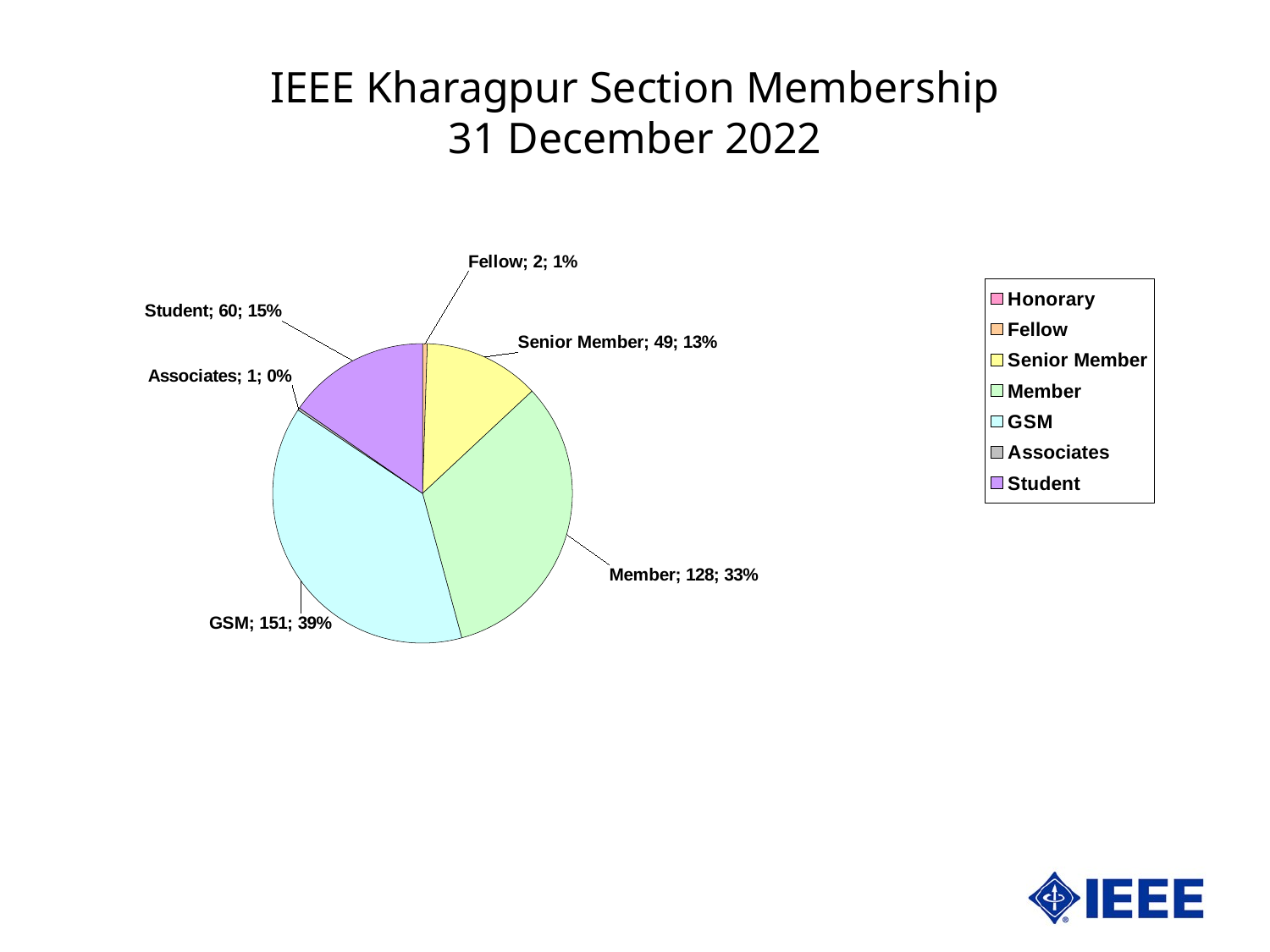
What is the difference between the GSM count and the Member count? 23 How many Senior Members are shown in the chart? 49 What is the value shown for Student? 60 What is the title of the chart? IEEE Kharagpur Section Membership 31 December 2022 How many entries does the legend list? 7 Which labelled category has the smallest value in the chart? Associates What kind of chart is shown on the slide? pie chart What percentage of the membership is Member? 33% Which is larger, the Student count or the Senior Member count? Student How many members does the GSM slice represent? 151 What share of the pie does the Student slice represent? 15% Which category has the largest slice of the pie? GSM